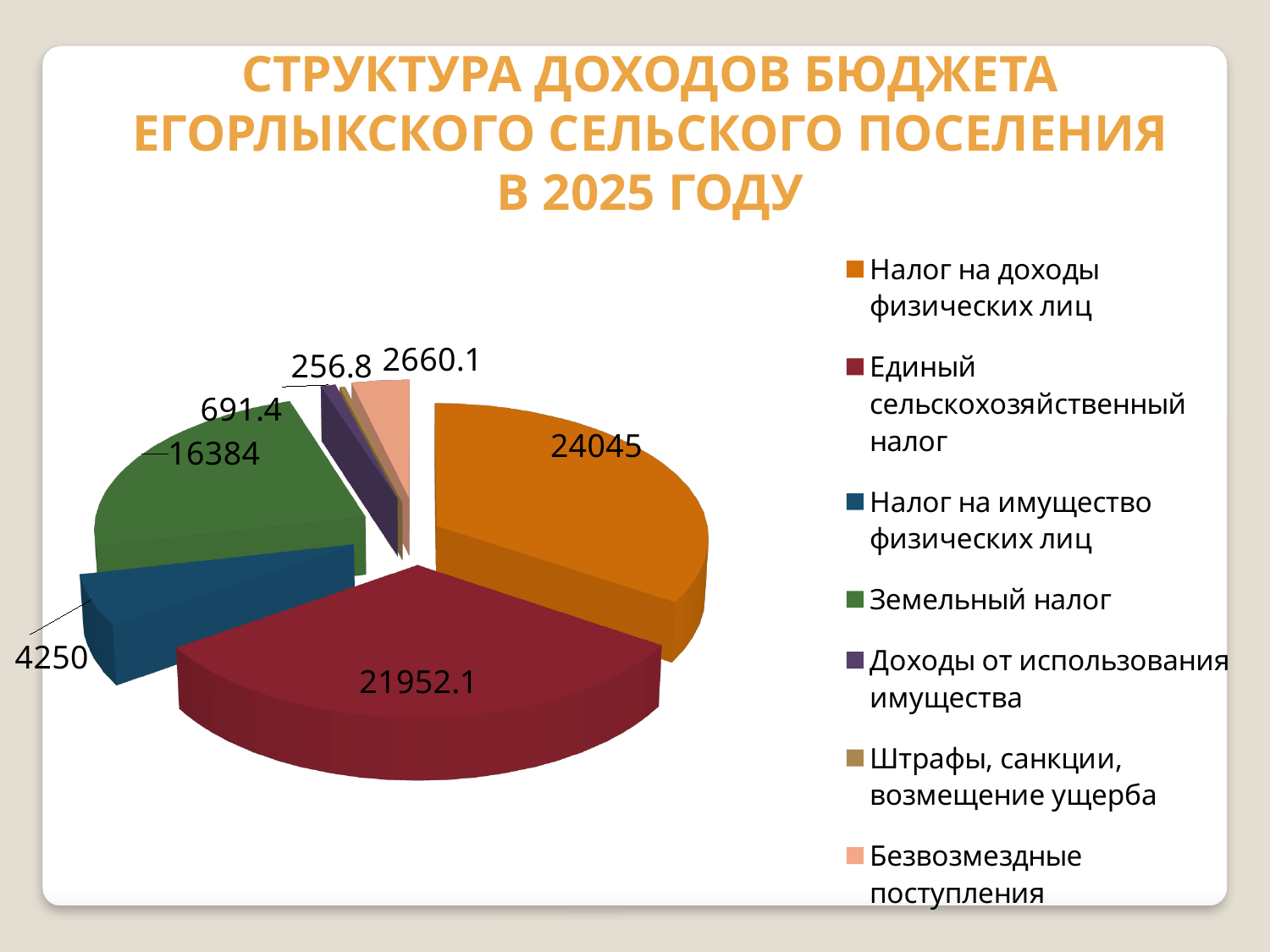
What is the difference between the values for Земельный налог and Налог на имущество физических лиц? 12134 Which category has the smallest slice of the pie? Штрафы, санкции, возмещение ущерба What is the difference between the values for Налог на доходы физических лиц and Единый сельскохозяйственный налог? 2092.9 How many categories does the legend list? 7 Which category has the largest slice of the pie? Налог на доходы физических лиц What is the value for Единый сельскохозяйственный налог? 21952.1 What is the value for Безвозмездные поступления? 2660.1 What is the value for Налог на доходы физических лиц? 24045 What is the value for Штрафы, санкции, возмещение ущерба? 256.8 Which is larger: Безвозмездные поступления or Доходы от использования имущества? Безвозмездные поступления What type of chart is shown on the slide? pie chart What is the value for Земельный налог? 16384